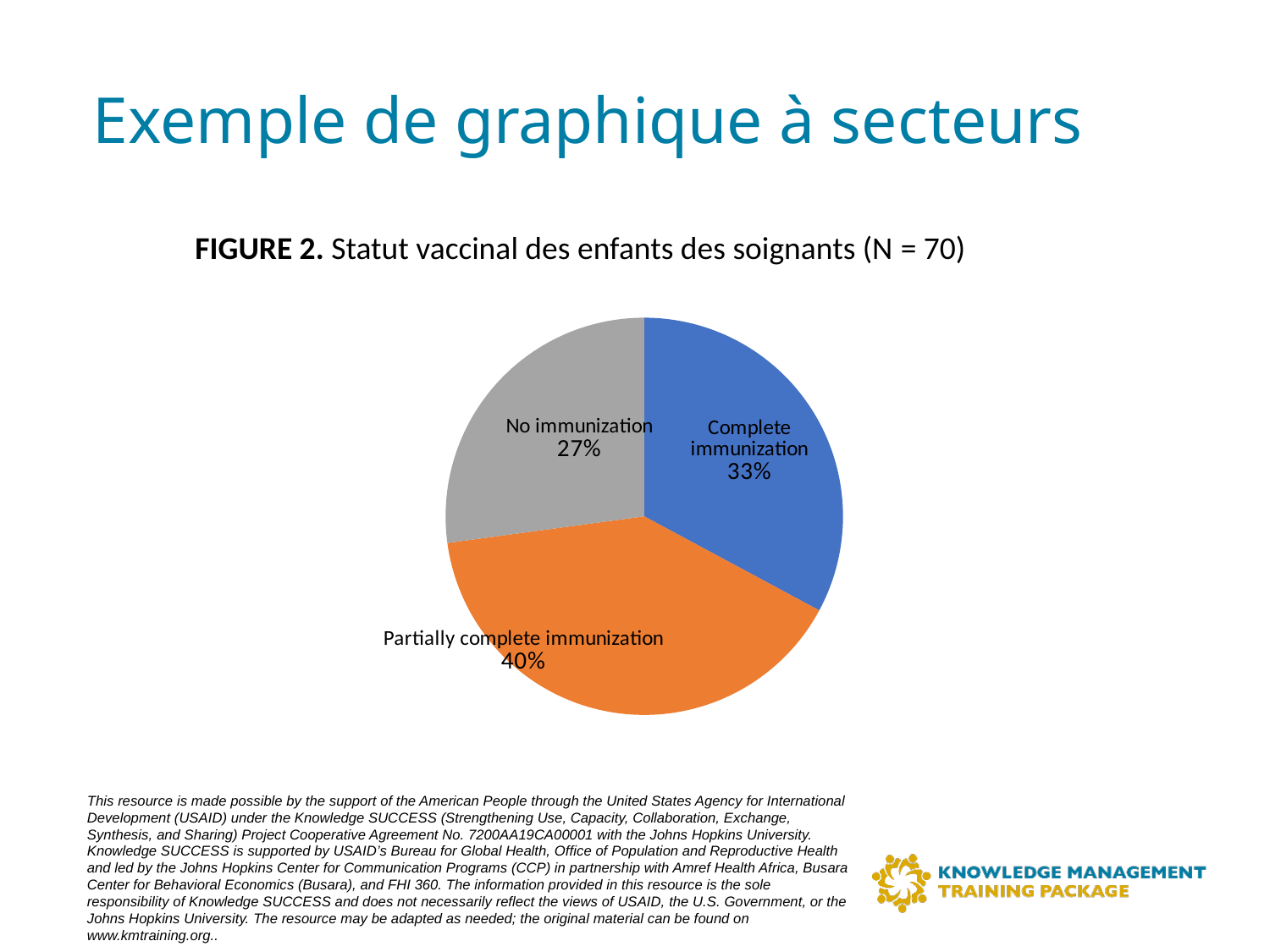
What is the sample size (N) stated in the chart title? 70 What is the difference in percentage points between "Partially complete immunization" and "No immunization"? 13 What kind of chart is shown on the slide? Pie chart Which category has the largest slice of the pie? Partially complete immunization Which category has the smallest slice of the pie? No immunization What is the difference in percentage points between "Complete immunization" and "No immunization"? 6 What share of the pie does "Complete immunization" represent? 33% What colour is the "Partially complete immunization" slice? Orange Which is larger, the share for "Complete immunization" or the share for "No immunization"? Complete immunization How many categories are shown in the pie chart? 3 What share of the pie does "No immunization" represent? 27% What share of the pie does "Partially complete immunization" represent? 40%